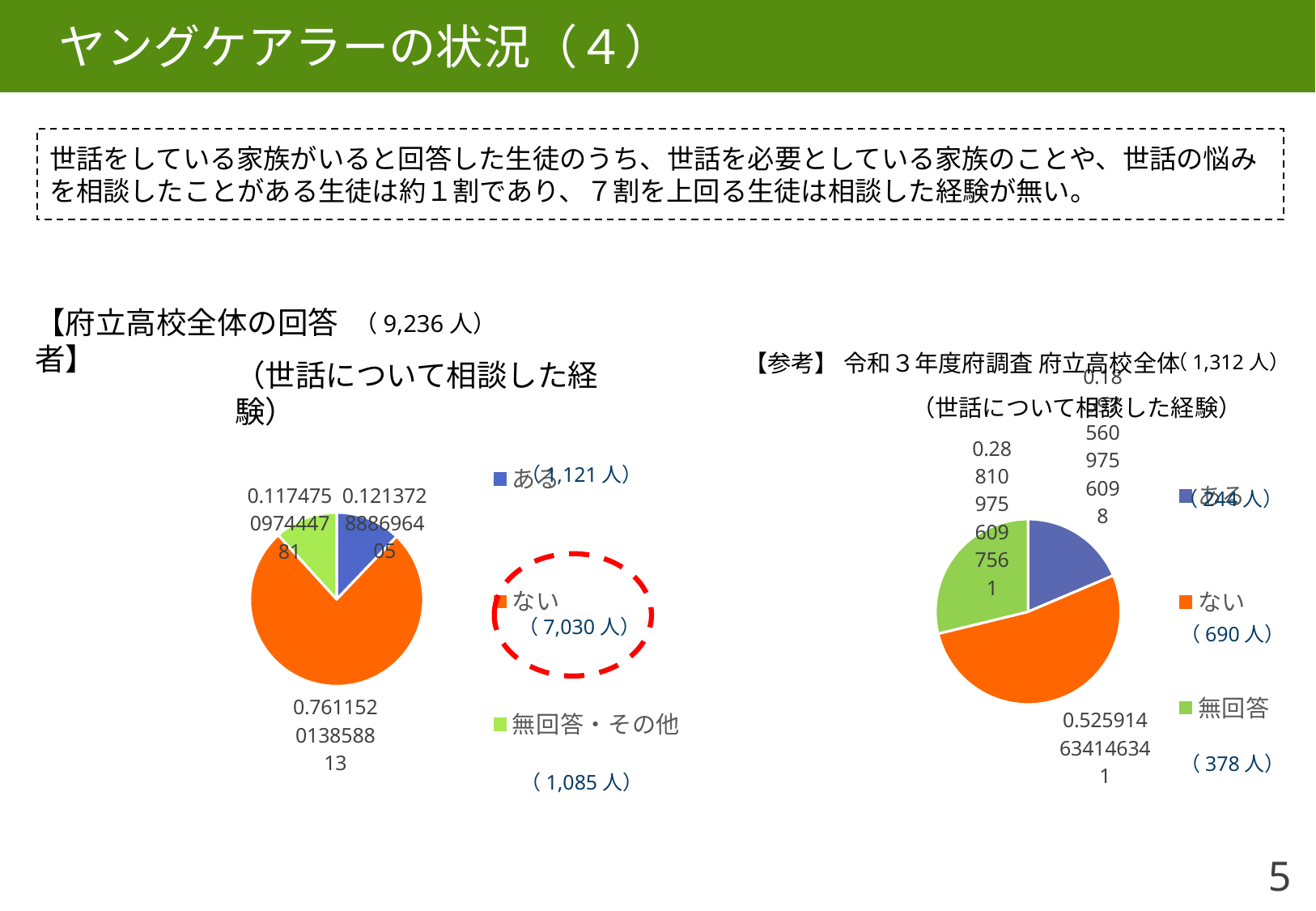
In the left pie chart (府立高校全体の回答者), which category has the largest share? ない How many categories does the left pie chart (府立高校全体の回答者) have? 3 In the left pie chart (府立高校全体の回答者), how many people are in the 無回答・その他 category? 1,085人 In the left pie chart (府立高校全体の回答者), how many more people answered ない than ある? 5,909人 In the left pie chart (府立高校全体の回答者), how many people answered ある? 1,121人 In the right pie chart (令和3年度府調査), which category has the smallest share? ある In the right pie chart (令和3年度府調査), how many people answered ある? 244人 What type of chart is used on the left side of the slide (府立高校全体の回答者)? pie chart In the right pie chart (令和3年度府調査), how many people answered ない? 690人 In the left pie chart (府立高校全体の回答者), how many people answered ない? 7,030人 How many entries does the legend of the right pie chart (令和3年度府調査) list? 3 In the right pie chart (令和3年度府調査), what is the difference between the number of people who answered ない and the number of 無回答? 312人